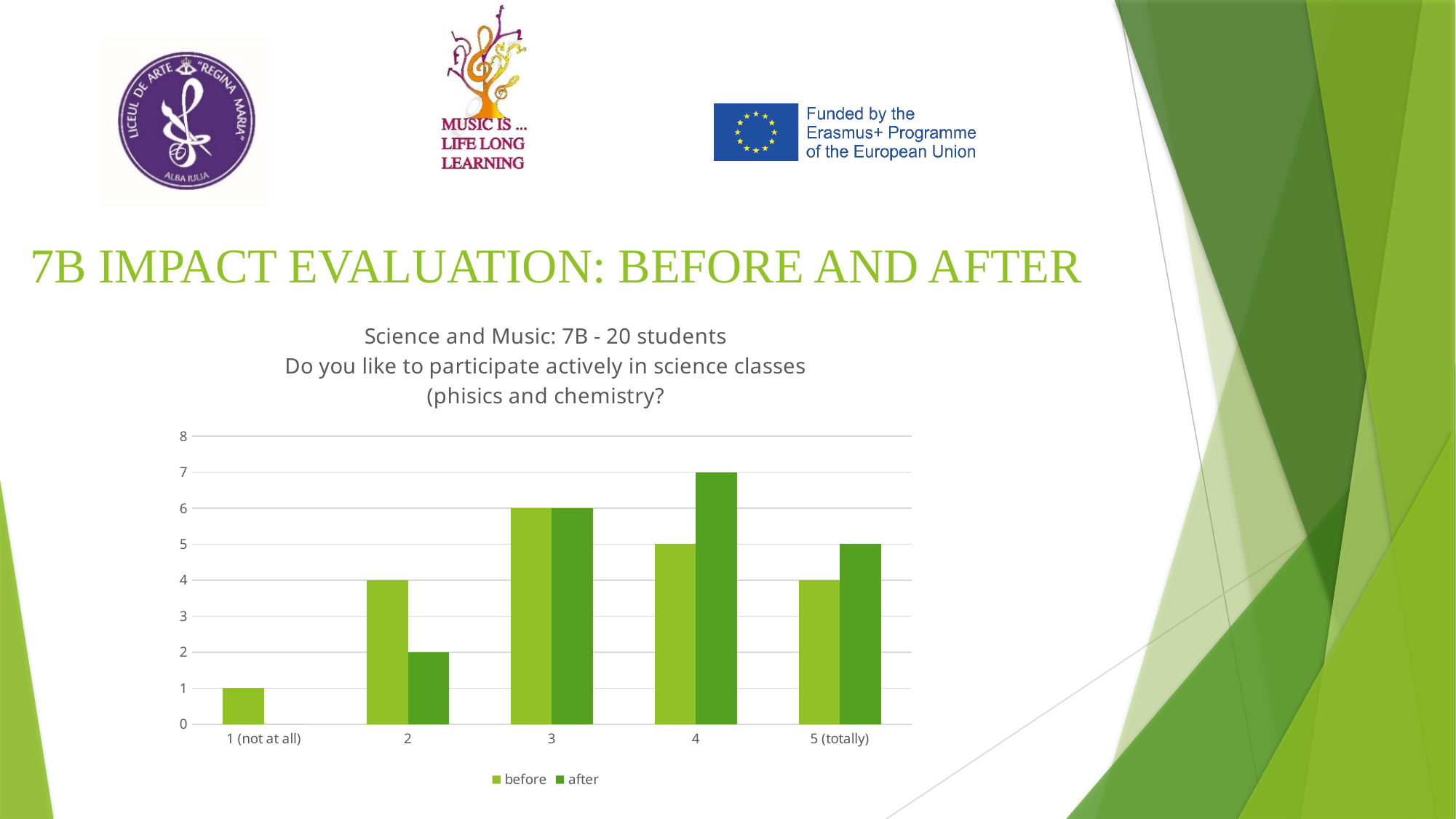
Which category has the lowest 'before' value? 1 (not at all) Which is larger for category 4, the 'before' value or the 'after' value? after What is the difference between the 'before' and 'after' values for category 2? 2 What is the 'after' value for category 4? 7 How many categories are shown on the x axis? 5 What is the 'before' value for category 3? 6 What kind of chart is shown on the slide? bar chart What is the 'after' value for '5 (totally)'? 5 How many series does the legend list? 2 What are the two series named in the legend? before and after Which category has the highest 'after' value? 4 What is the 'before' value for '1 (not at all)'? 1